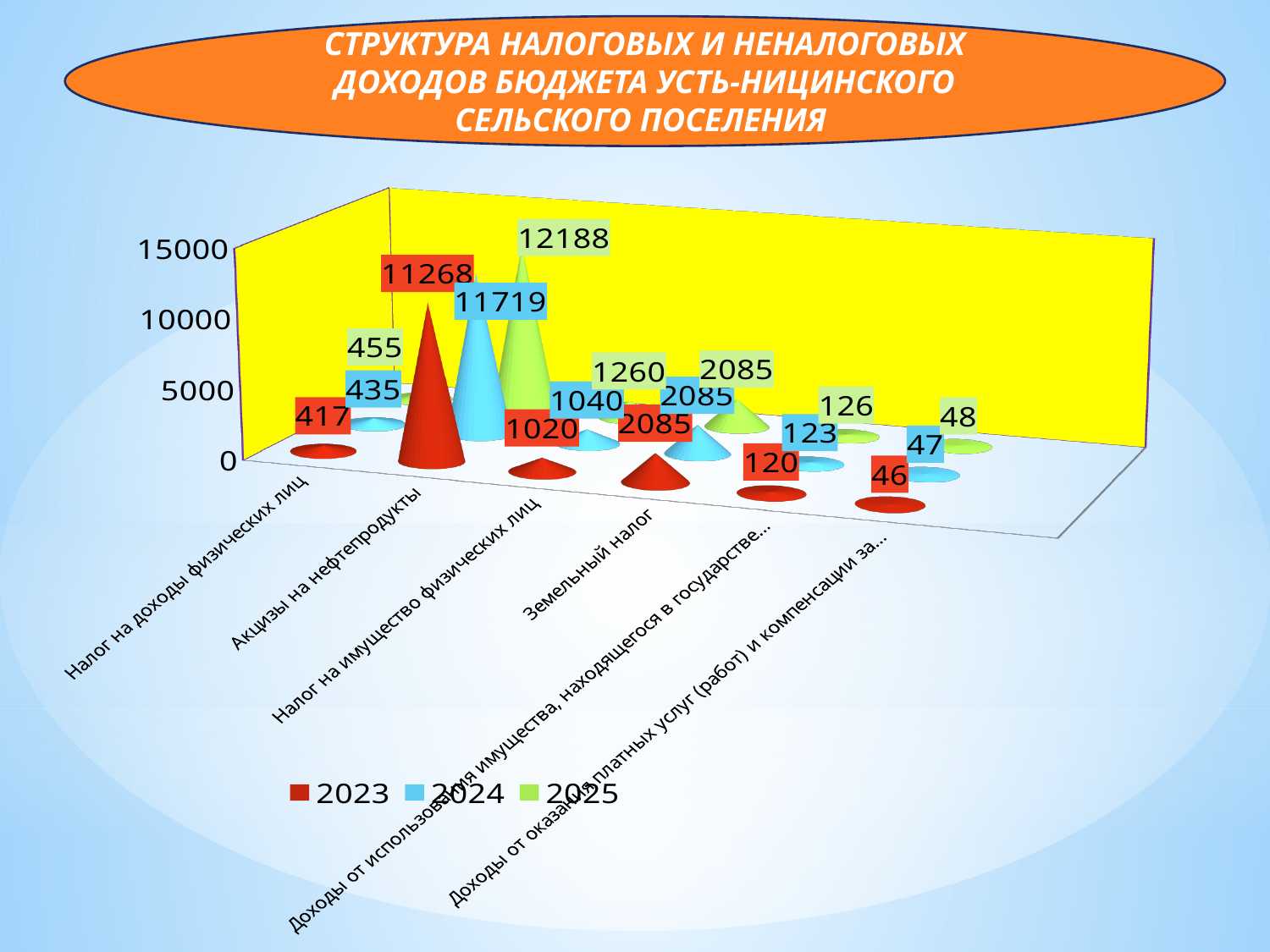
How many series does the legend list? 3 What kind of chart is shown on the slide? Bar chart How many categories are shown on the x axis? 6 What is the value for Налог на имущество физических лиц in the 2024 series? 1040 Which series is shown in red in the legend? 2023 What is the value for Земельный налог in the 2025 series? 2085 Which category has the highest value in the 2023 series? Акцизы на нефтепродукты Which category has the lowest value in the 2024 series? Доходы от оказания платных услуг (работ) и компенсации за... Which is larger: the 2025 value for Налог на имущество физических лиц or the 2025 value for Налог на доходы физических лиц? Налог на имущество физических лиц What is the value for Налог на доходы физических лиц in the 2023 series? 417 What is the value for Акцизы на нефтепродукты in the 2025 series? 12188 What is the difference between the 2025 and 2023 values for Акцизы на нефтепродукты? 920